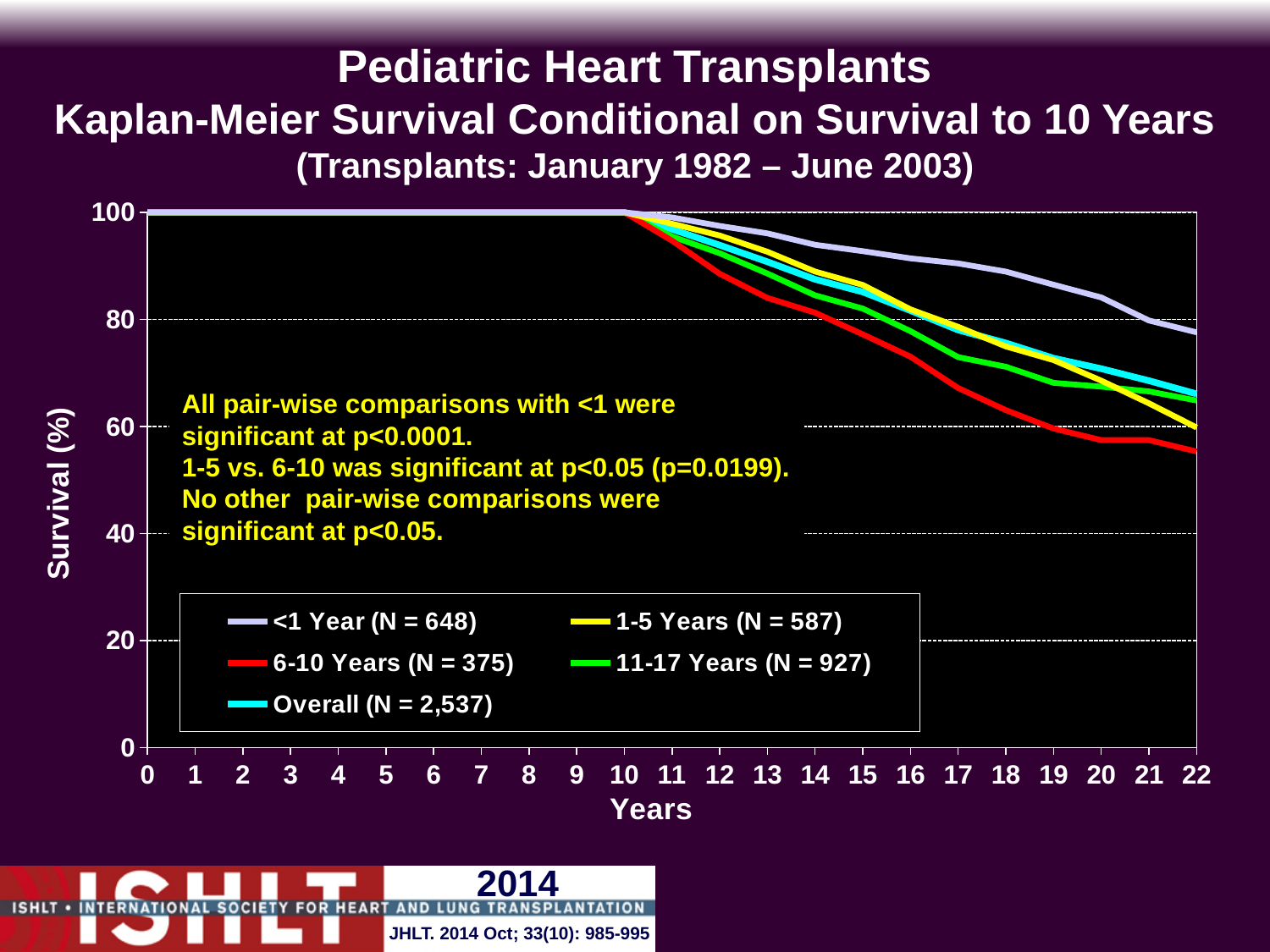
Is the survival value for 6-10 Years at year 22 greater or less than 60? less Which series has the lowest survival at year 22? 6-10 Years (N = 375) What kind of chart is shown on the slide? line chart Is the survival value for 11-17 Years at year 22 greater or less than 60? greater How many series does the legend list? 5 At year 15, which series has higher survival: <1 Year or 6-10 Years? <1 Year What is the N value shown in the legend for the Overall series? 2,537 Is the survival value for <1 Year at year 22 greater or less than 60? greater Which series has the highest survival at year 22? <1 Year (N = 648) Do the survival curves rise or fall along the x axis after year 10? fall What is the label of the y axis? Survival (%) At year 18, which series has higher survival: 11-17 Years or 6-10 Years? 11-17 Years